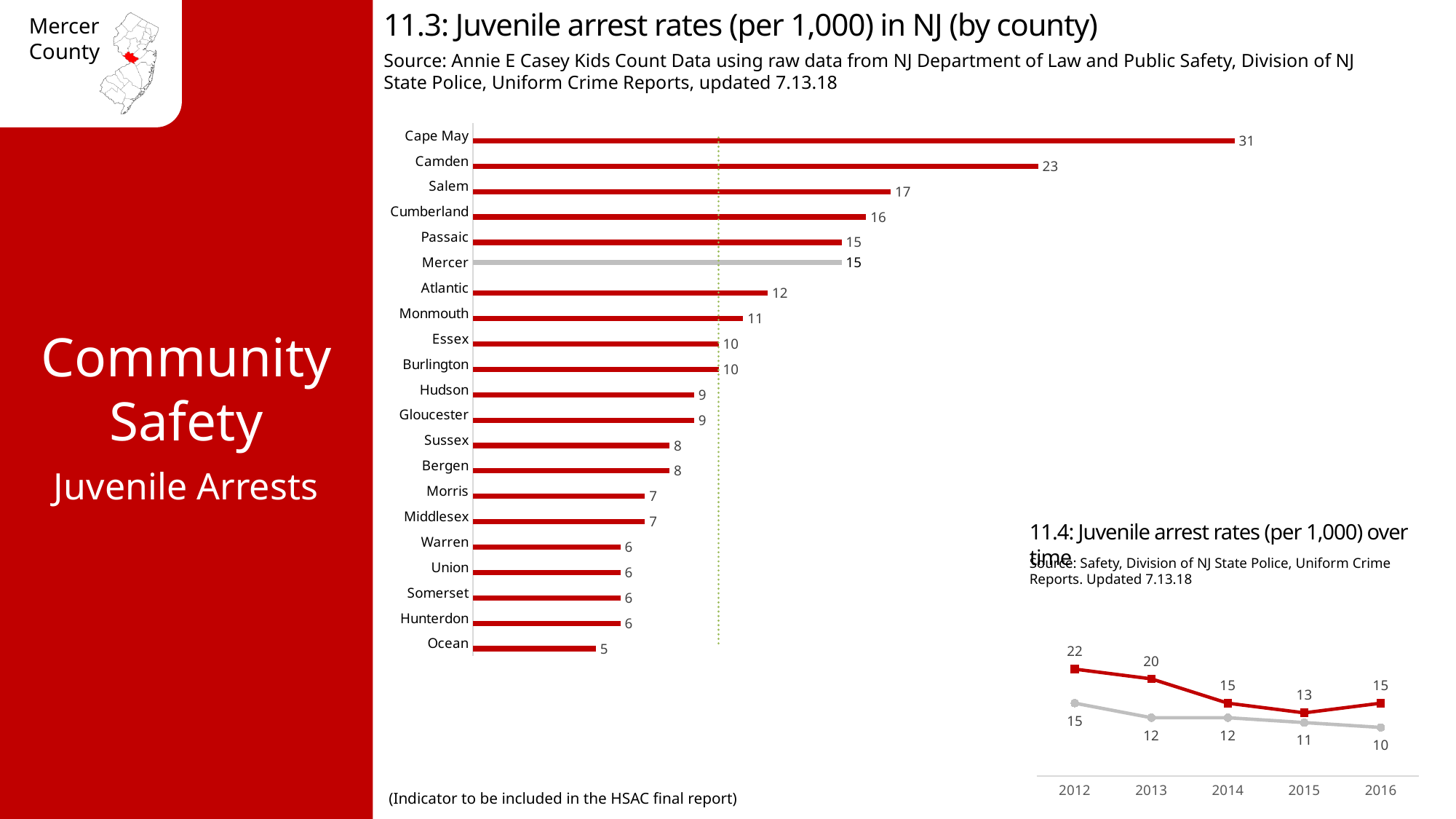
In chart 11.4 (juvenile arrest rates over time), what is the value of the red line in 2012? 22 What kind of chart is chart 11.3 (juvenile arrest rates by county)? Bar chart In chart 11.4 (juvenile arrest rates over time), what is the value of the grey line in 2016? 10 In chart 11.3 (juvenile arrest rates by county), which county has the highest rate? Cape May In chart 11.4 (juvenile arrest rates over time), does the grey line rise or fall from 2012 to 2016? Fall In chart 11.3 (juvenile arrest rates by county), how many counties are shown? 21 In chart 11.3 (juvenile arrest rates by county), which is larger, the value for Salem or the value for Atlantic? Salem In chart 11.3 (juvenile arrest rates by county), which county has the lowest rate? Ocean In chart 11.4 (juvenile arrest rates over time), how many years are plotted on the x axis? 5 In chart 11.3 (juvenile arrest rates by county), what is the value for Hudson? 9 In chart 11.3 (juvenile arrest rates by county), what is the difference between Cape May and Camden? 8 In chart 11.3 (juvenile arrest rates by county), what is the value for Mercer? 15